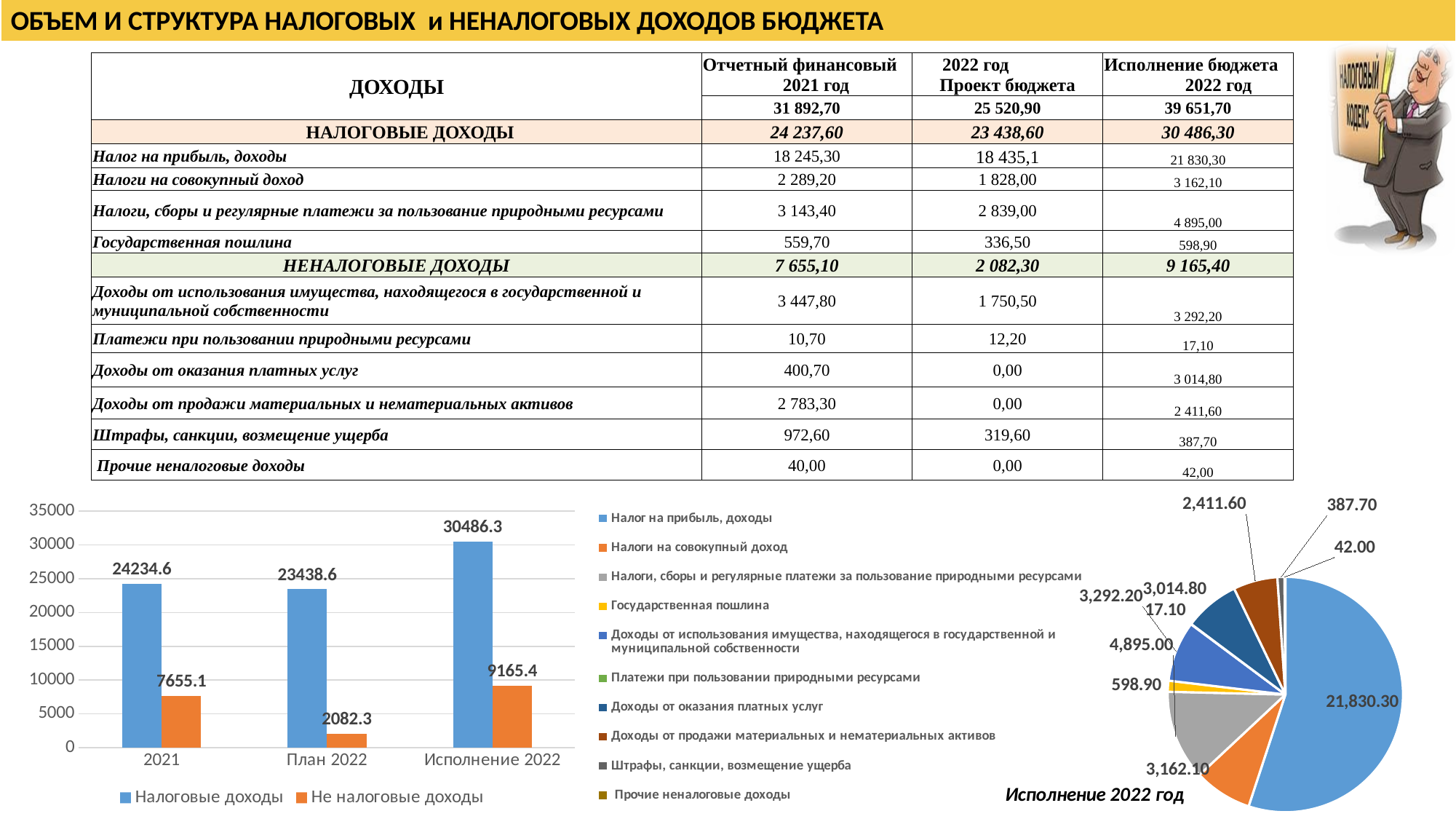
What type of chart is shown at the bottom left of the slide? bar chart In the bar chart at the bottom left, what is the difference between Налоговые доходы for Исполнение 2022 and for 2021? 6251.7 In the pie chart titled Исполнение 2022 год, which category has the smallest slice? Платежи при пользовании природными ресурсами In the pie chart titled Исполнение 2022 год, how many entries does the legend list? 10 In the bar chart at the bottom left, how many categories are shown on the x axis? 3 In the pie chart titled Исполнение 2022 год, what is the value for Налог на прибыль, доходы? 21,830.30 In the bar chart at the bottom left, how many series does the legend list? 2 In the bar chart at the bottom left, what is the value of Налоговые доходы for Исполнение 2022? 30486.3 In the bar chart at the bottom left, what is the value of Не налоговые доходы for План 2022? 2082.3 In the bar chart at the bottom left, which category has the highest value for Налоговые доходы? Исполнение 2022 In the bar chart at the bottom left, which category has the lowest value for Не налоговые доходы? План 2022 In the pie chart titled Исполнение 2022 год, which is larger: the value for Доходы от оказания платных услуг or the value for Доходы от продажи материальных и нематериальных активов? Доходы от оказания платных услуг